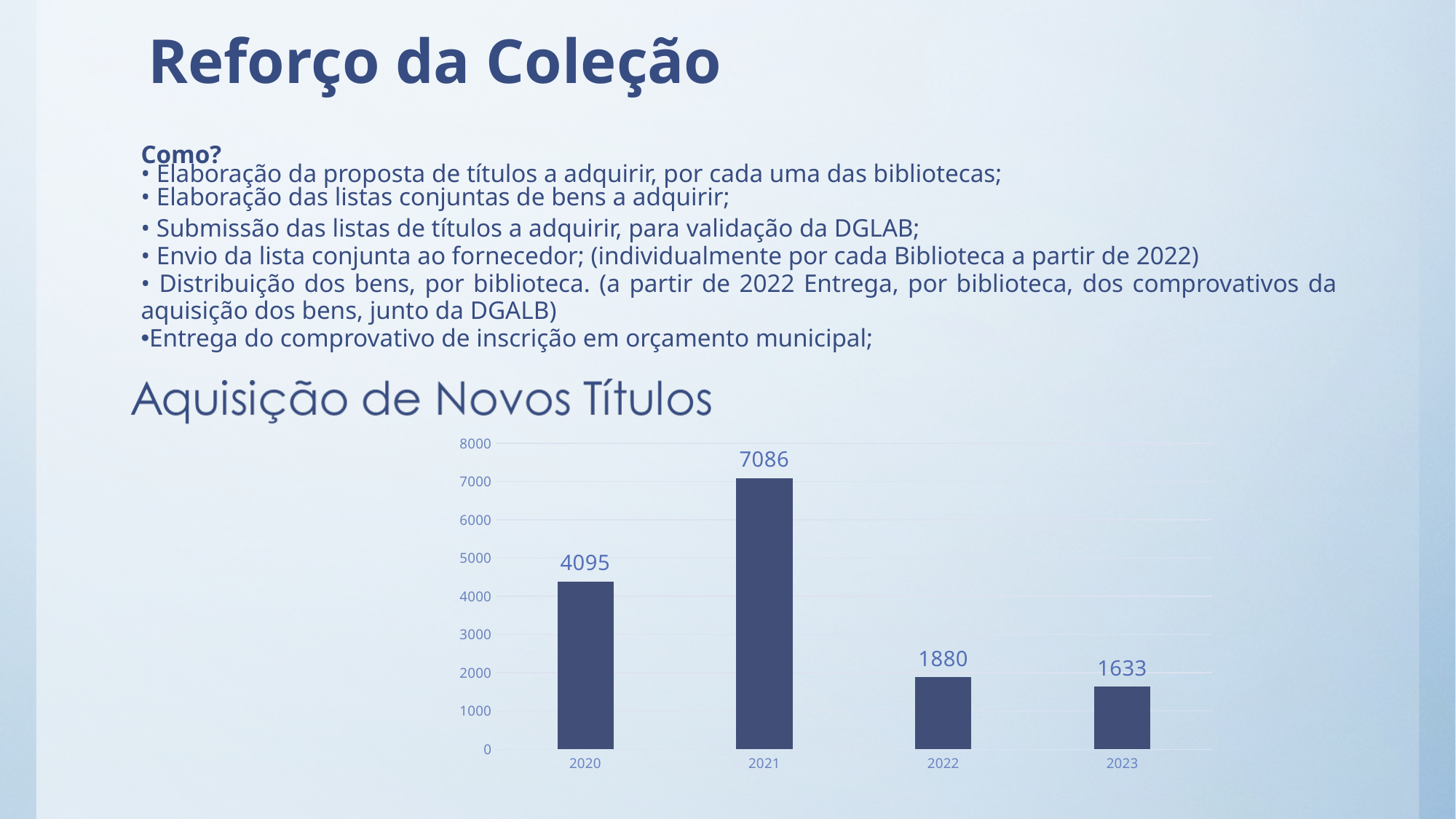
What is the difference between the values for 2022 and 2023 in the Aquisição de Novos Títulos chart? 247 What is the difference between the values for 2021 and 2020 in the Aquisição de Novos Títulos chart? 2991 What is the value for 2020 in the Aquisição de Novos Títulos chart? 4095 What kind of chart is the Aquisição de Novos Títulos chart? bar chart Which year has the highest value in the Aquisição de Novos Títulos chart? 2021 What is the value for 2021 in the Aquisição de Novos Títulos chart? 7086 What is the title of the chart on the slide? Aquisição de Novos Títulos How many years are shown on the x axis of the Aquisição de Novos Títulos chart? 4 What is the value for 2023 in the Aquisição de Novos Títulos chart? 1633 Which is larger in the Aquisição de Novos Títulos chart, the value for 2020 or the value for 2022? 2020 Which year has the lowest value in the Aquisição de Novos Títulos chart? 2023 What is the value for 2022 in the Aquisição de Novos Títulos chart? 1880